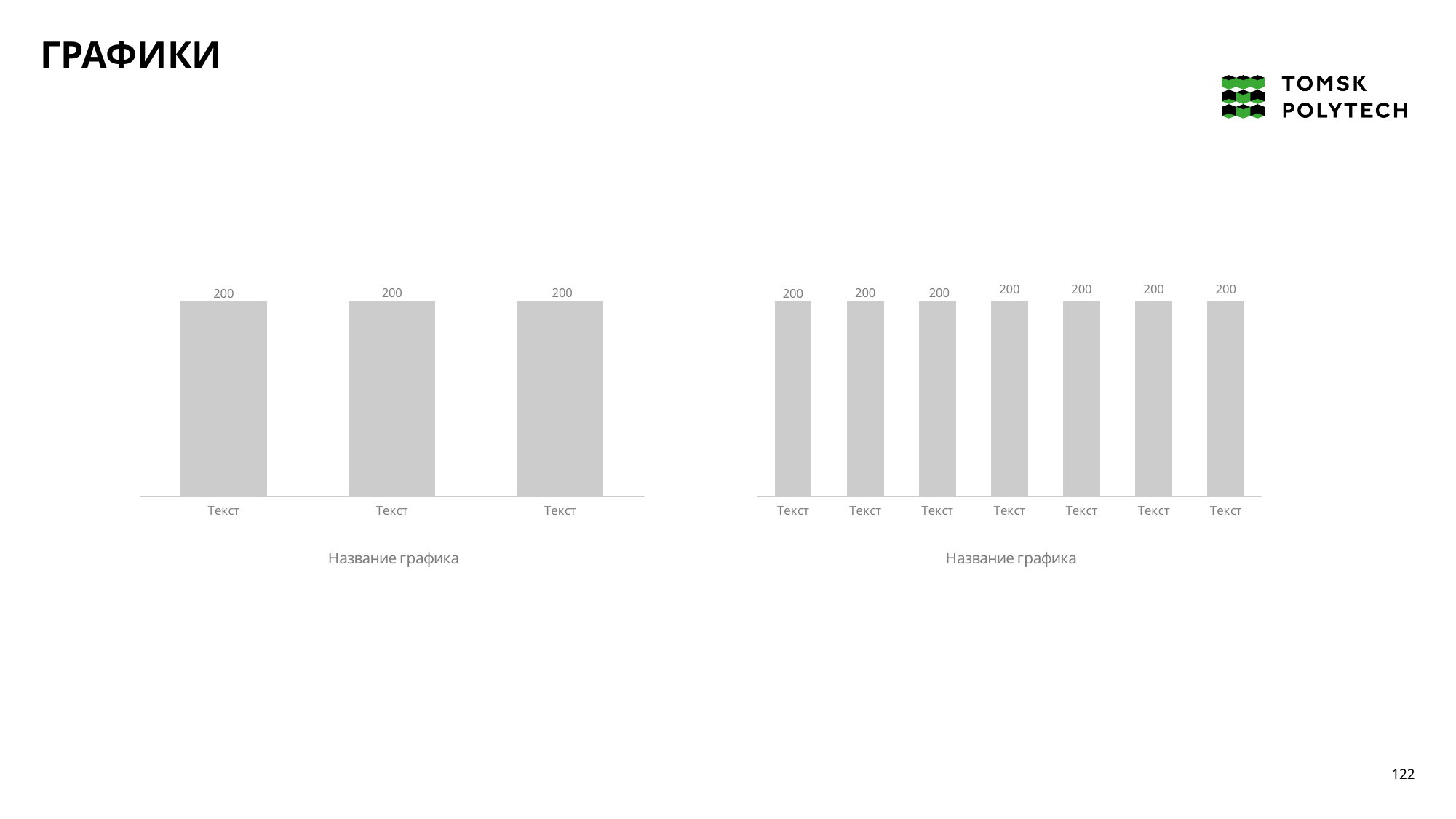
What is the title of the left chart? Название графика In the right chart, what is the value shown on the fourth bar? 200 What type of chart is the left chart on the slide? bar chart How many bars does the left chart have? 3 In the right chart, what is the value shown on the last (rightmost) bar? 200 What category label is shown under each bar in the right chart? Текст Do the values in the right chart rise, fall, or stay the same from left to right? stay the same How many bars does the right chart have? 7 In the left chart, what is the difference between the first bar and the third bar? 0 In the left chart, what is the value shown on the first bar? 200 In the right chart, what is the difference between the first bar and the seventh bar? 0 What type of chart is the right chart on the slide? bar chart